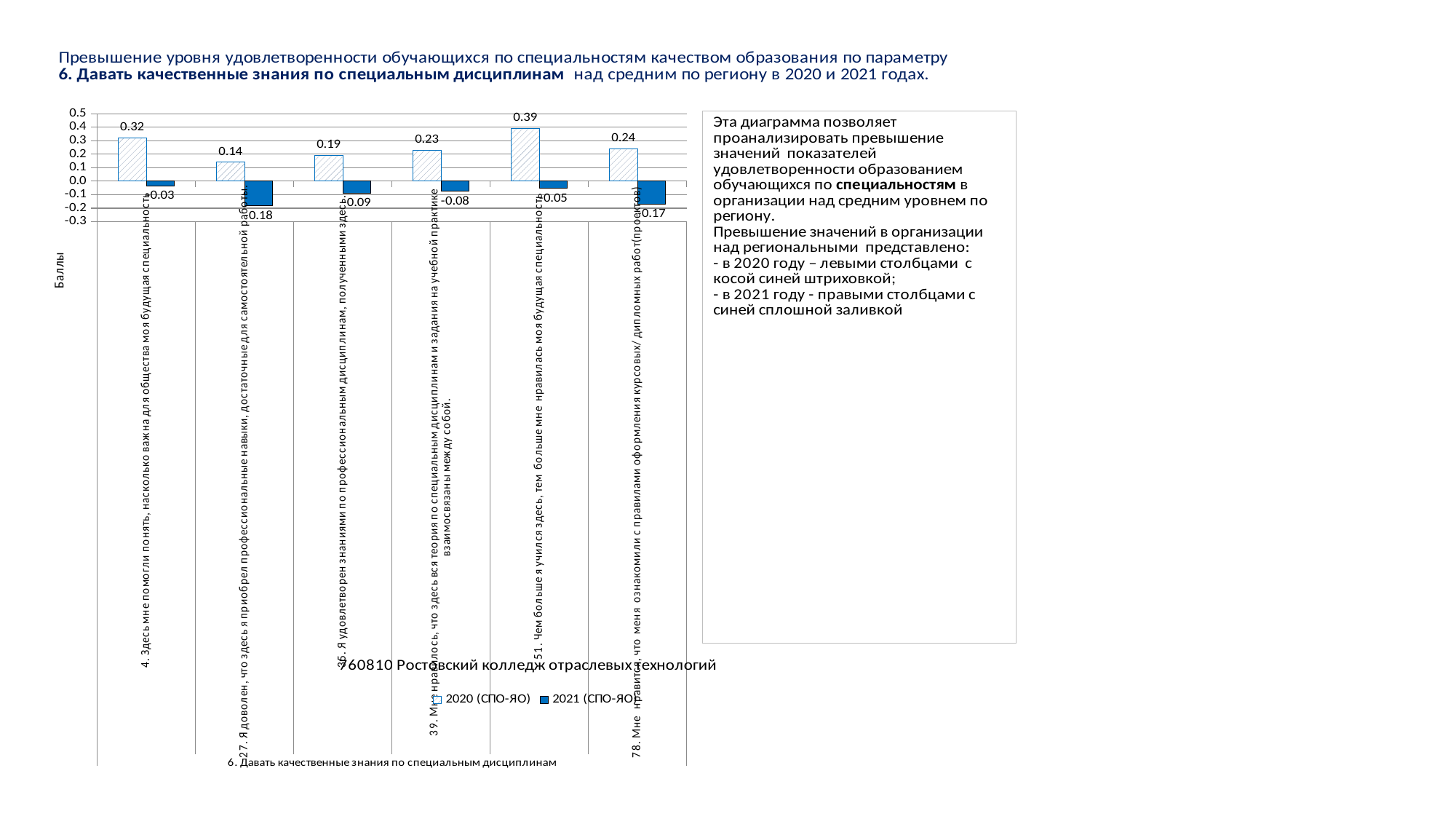
Which statement has the highest 2020 (СПО-ЯО) value? 51. Чем больше я учился здесь, тем больше мне нравилась моя будущая специальность What is the 2020 (СПО-ЯО) value for statement 51 ("Чем больше я учился здесь, тем больше мне нравилась моя будущая специальность")? 0.39 What is the 2020 (СПО-ЯО) value for statement 4 ("Здесь мне помогли понять, насколько важна для общества моя будущая специальность")? 0.32 What is the 2021 (СПО-ЯО) value for statement 27 ("Я доволен, что здесь я приобрел профессиональные навыки...")? -0.18 What type of chart is shown on the slide? bar chart What is the 2021 (СПО-ЯО) value for statement 78 ("Мне нравится, что меня ознакомили с правилами оформления курсовых/дипломных работ")? -0.17 What is the difference between the 2020 and 2021 values for statement 39 ("Мне нравилось, что здесь вся теория по специальным дисциплинам и задания на учебной практике взаимосвязаны между собой")? 0.31 How many series does the chart legend list? 2 Which is larger: the 2020 value for statement 35 or the 2020 value for statement 78? statement 78 (0.24) How many categories (statements) are plotted on the chart? 6 Which statement has the lowest 2021 (СПО-ЯО) value? 27. Я доволен, что здесь я приобрел профессиональные навыки, достаточные для самостоятельной работы